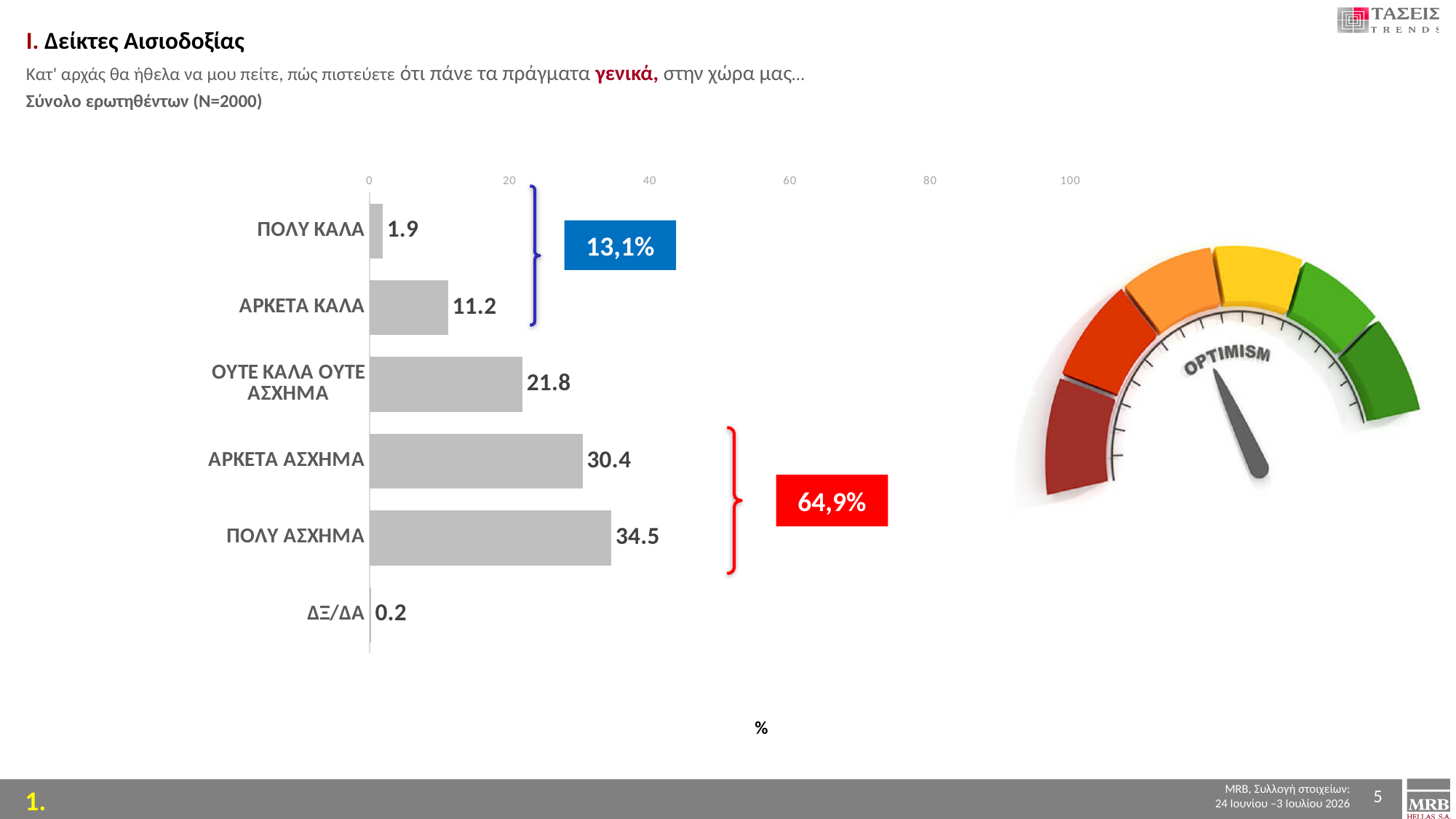
Is the value for ΑΡΚΕΤΑ ΑΣΧΗΜΑ greater or less than 20? greater What is the value for ΔΞ/ΔΑ? 0.2 What is the value for ΠΟΛΥ ΑΣΧΗΜΑ? 34.5 Which is larger, the value for ΑΡΚΕΤΑ ΚΑΛΑ or the value for ΟΥΤΕ ΚΑΛΑ ΟΥΤΕ ΑΣΧΗΜΑ? ΟΥΤΕ ΚΑΛΑ ΟΥΤΕ ΑΣΧΗΜΑ What kind of chart is used to show the responses? bar chart Which category has the lowest value? ΔΞ/ΔΑ What is the value for ΑΡΚΕΤΑ ΚΑΛΑ? 11.2 How many categories are shown in the bar chart? 6 Which category has the highest value? ΠΟΛΥ ΑΣΧΗΜΑ What is the value for ΟΥΤΕ ΚΑΛΑ ΟΥΤΕ ΑΣΧΗΜΑ? 21.8 What combined percentage is shown in the red box for the two negative categories? 64,9% What is the difference between the values for ΠΟΛΥ ΑΣΧΗΜΑ and ΑΡΚΕΤΑ ΑΣΧΗΜΑ? 4.1